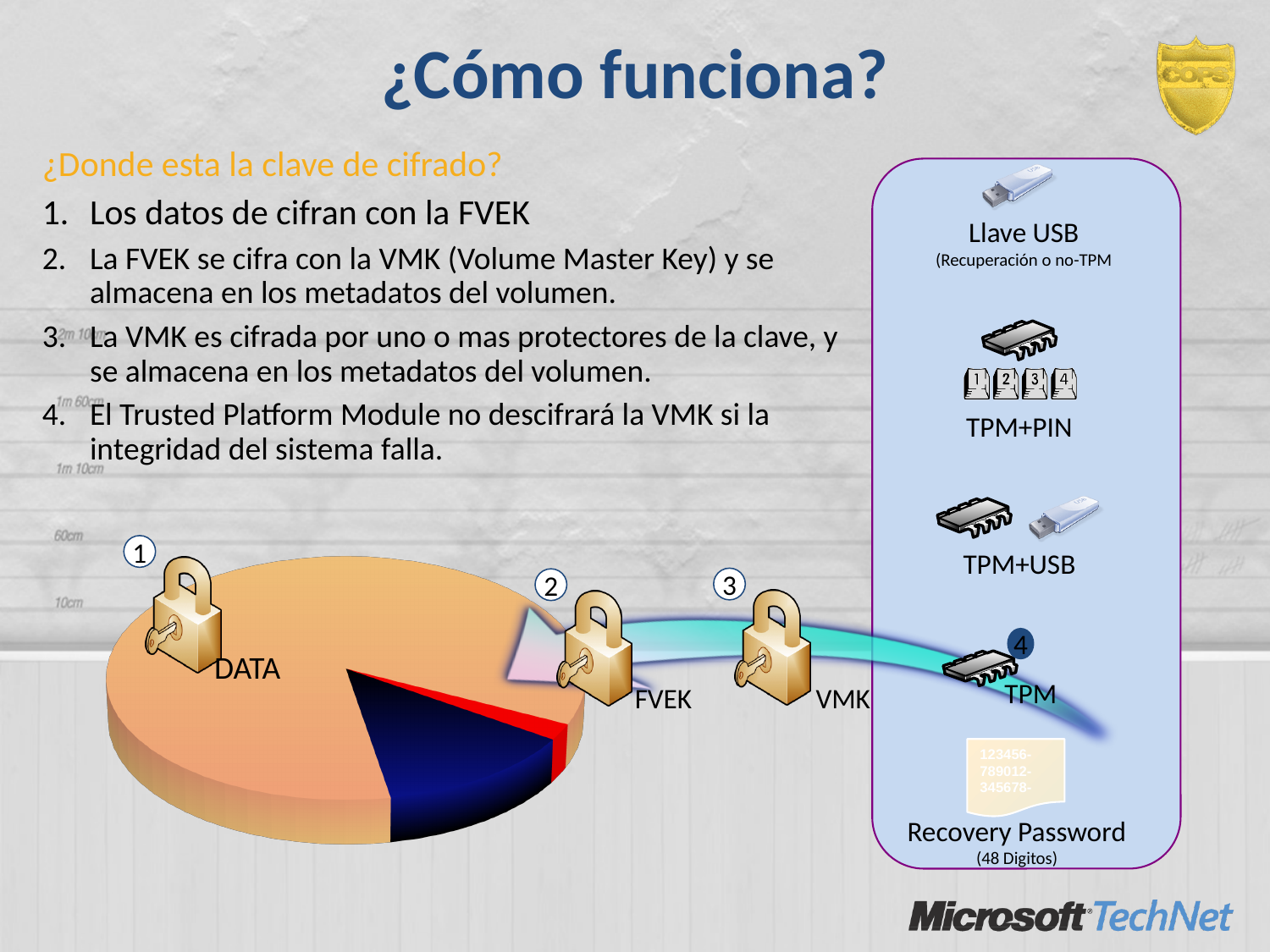
Which slice of the pie chart is pulled out (exploded) from the rest? the dark blue slice Which colour slice takes up the largest share of the pie chart? orange What kind of chart is shown at the bottom left of the slide? pie chart Does the pie chart display any numeric data labels on its slices? No Is the orange slice of the pie chart larger or smaller than the dark blue slice? larger